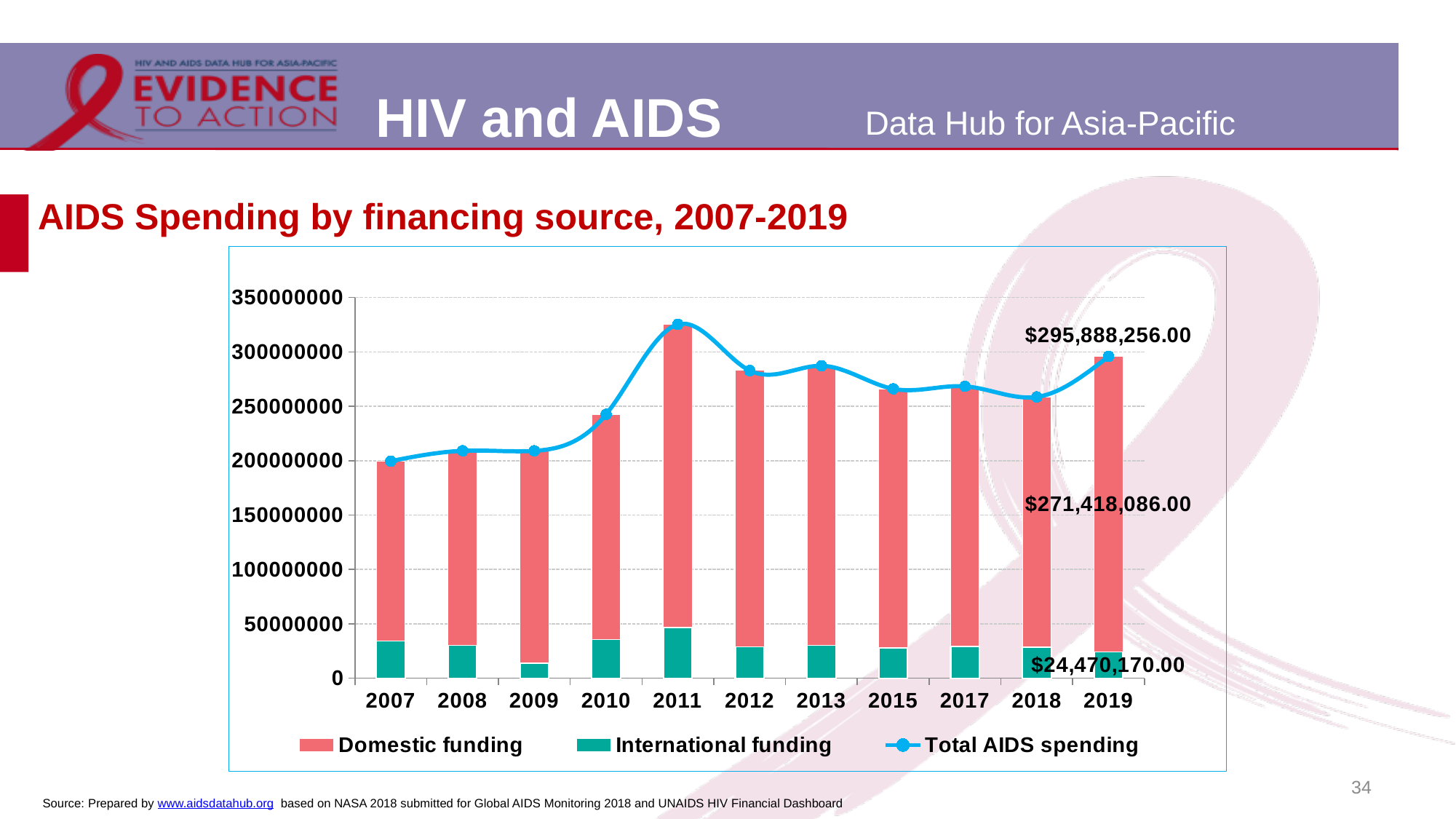
How many series does the legend list? 3 What is the Total AIDS spending value labelled for 2019? $295,888,256.00 What is the difference between Domestic funding and International funding in 2019? $246,947,916.00 Is Total AIDS spending in 2007 greater or less than 250000000? less In which year is Total AIDS spending highest? 2011 What is the Domestic funding value labelled for 2019? $271,418,086.00 How many years are shown on the x axis? 11 Which year has higher Total AIDS spending, 2010 or 2009? 2010 Is Total AIDS spending in 2011 greater or less than 300000000? greater In which year is International funding lowest? 2009 What is the International funding value labelled for 2019? $24,470,170.00 In which year is Total AIDS spending lowest? 2007